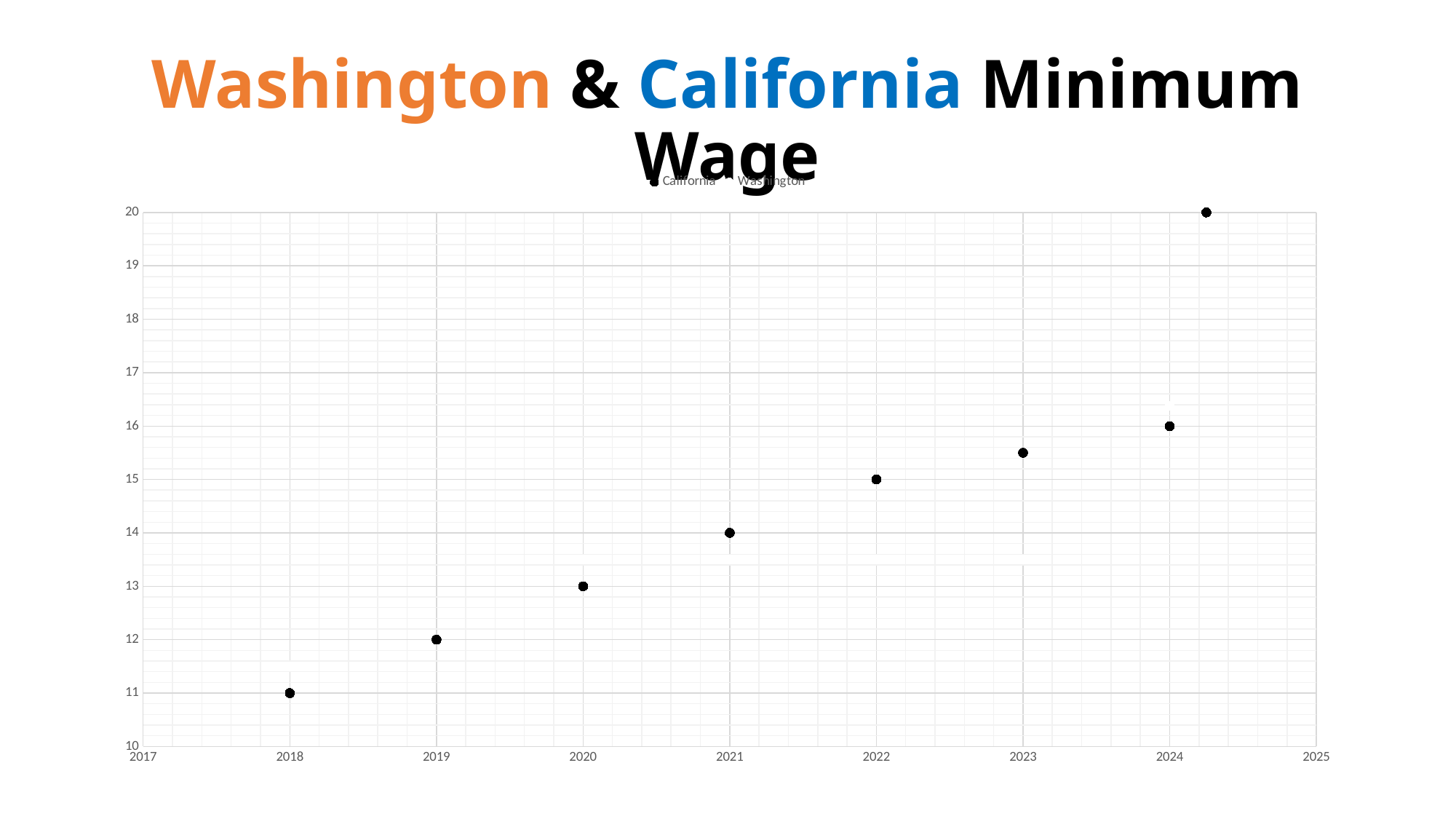
Is the value of the point plotted at 2019 greater or less than 13? less What value does the point plotted at 2020 land on? 13 How many series does the chart legend list? 2 What kind of chart is shown on the slide? scatter chart What is the difference between the point plotted at 2021 and the point plotted at 2018? 3 What value does the point plotted at 2022 land on? 15 Do the plotted values rise or fall as the years increase along the x axis? rise What is the title of the slide's chart? Washington & California Minimum Wage What value does the point plotted at 2024 land on? 16 What value does the point plotted at 2018 land on? 11 What is the highest value any point on the chart reaches? 20 Is the value of the point plotted at 2023 greater or less than 15? greater